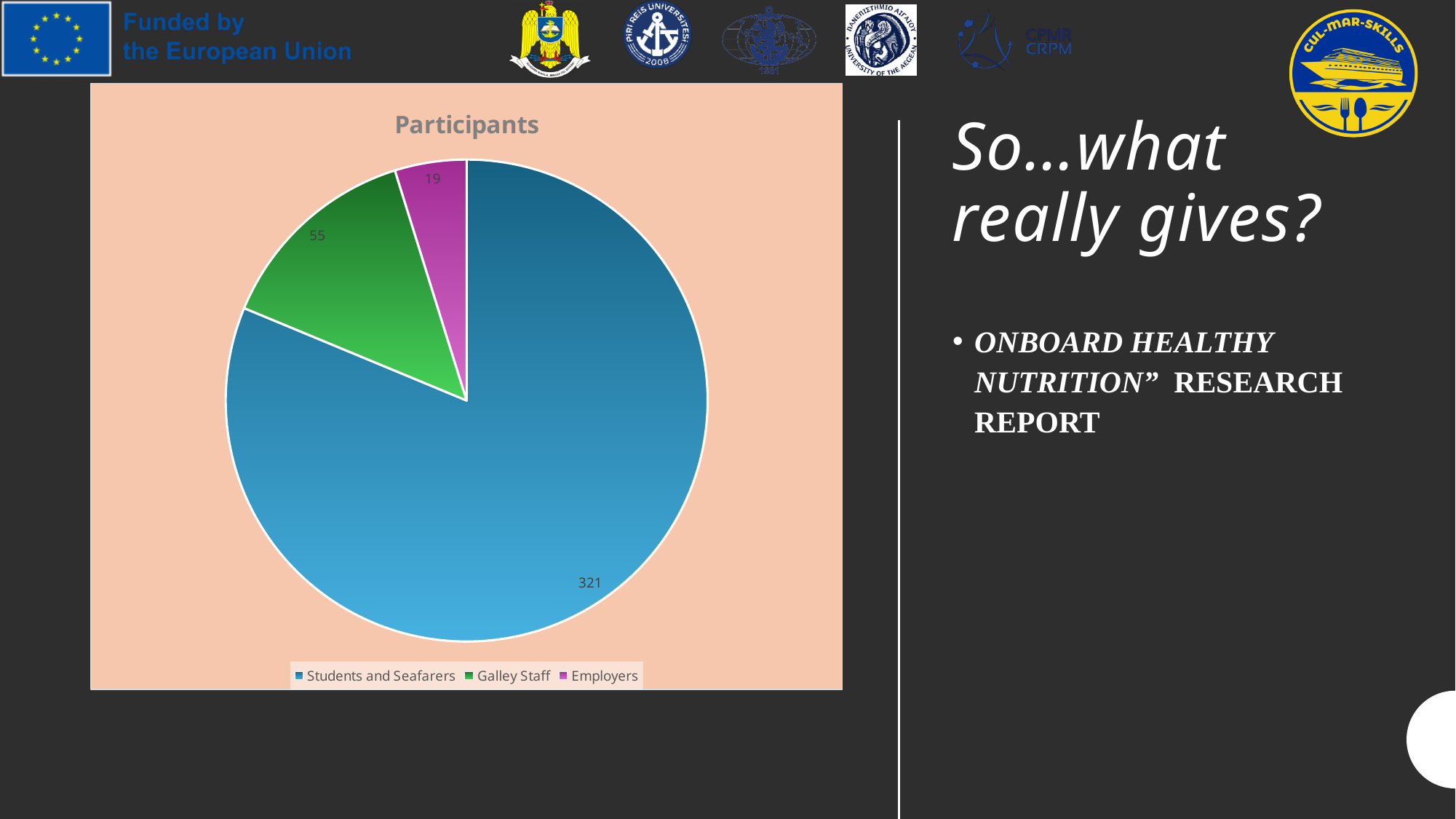
What is the value for Students and Seafarers? 321 What is the title of the chart? Participants What is the difference between the values for Galley Staff and Employers? 36 How many categories does the pie chart show? 3 What is the value for Galley Staff? 55 Which category has the largest slice? Students and Seafarers Which is larger, the value for Galley Staff or the value for Employers? Galley Staff Which colour represents Galley Staff in the legend? Green What kind of chart is shown on the slide? Pie chart What is the total of all three slices in the pie chart? 395 Which category has the smallest slice? Employers What is the value for Employers? 19